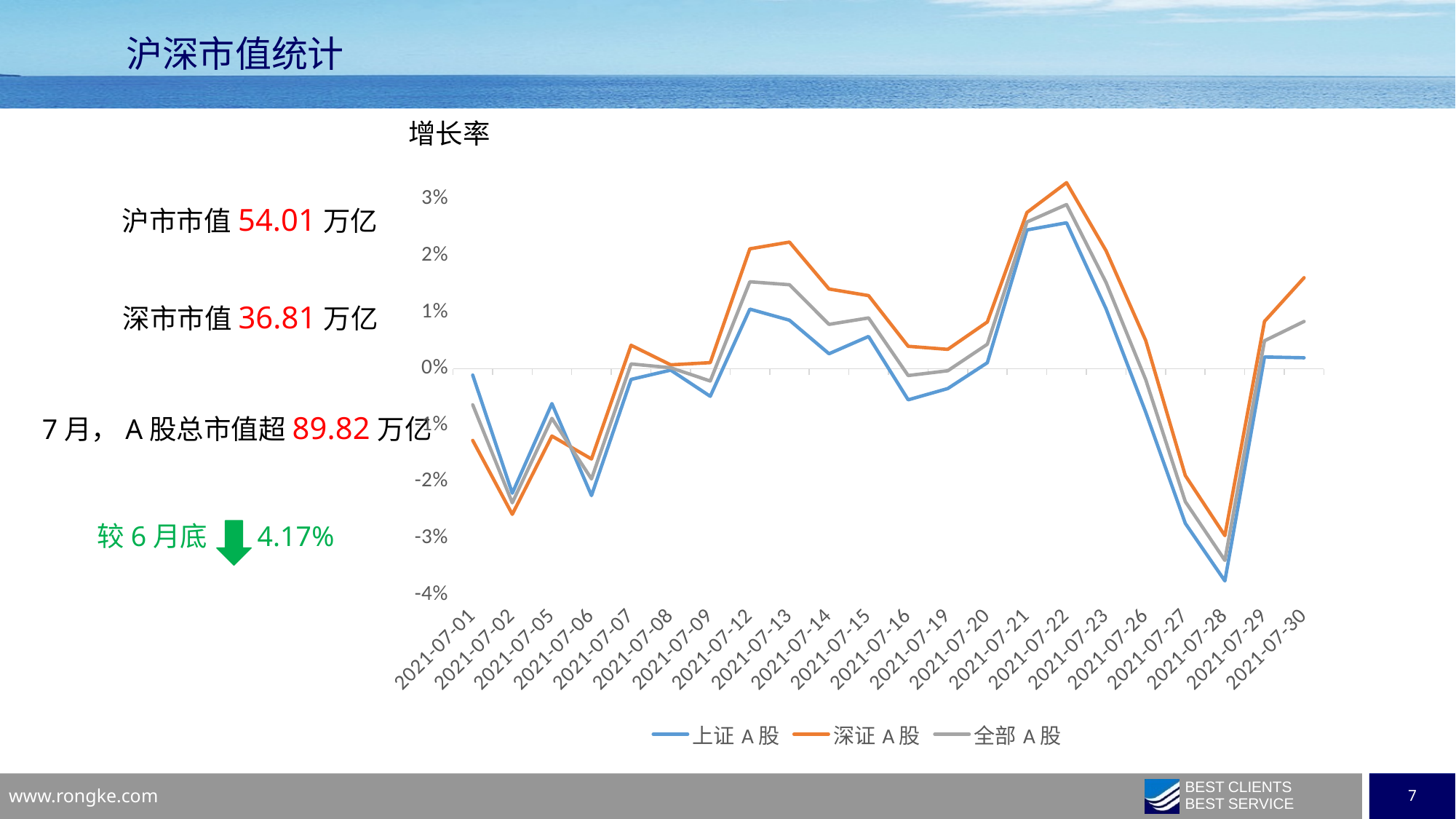
Is the value for 上证 A 股 on 2021-07-22 greater or less than 2%? greater What is the title of the chart? 增长率 Is the value for 深证 A 股 on 2021-07-02 greater or less than -2%? less On which date does the 上证 A 股 series reach its lowest value? 2021-07-28 Which series is drawn in orange in the chart? 深证 A 股 How many dates are plotted along the x axis of the chart? 22 On 2021-07-13, which series has the higher value, 上证 A 股 or 深证 A 股? 深证 A 股 Is the value for 上证 A 股 on 2021-07-28 greater or less than -3%? less Do the values of all three series rise or fall between 2021-07-22 and 2021-07-28? fall On which date does the 深证 A 股 series reach its highest value? 2021-07-22 What kind of chart is shown on the slide? Line chart How many series does the legend of the chart list? 3